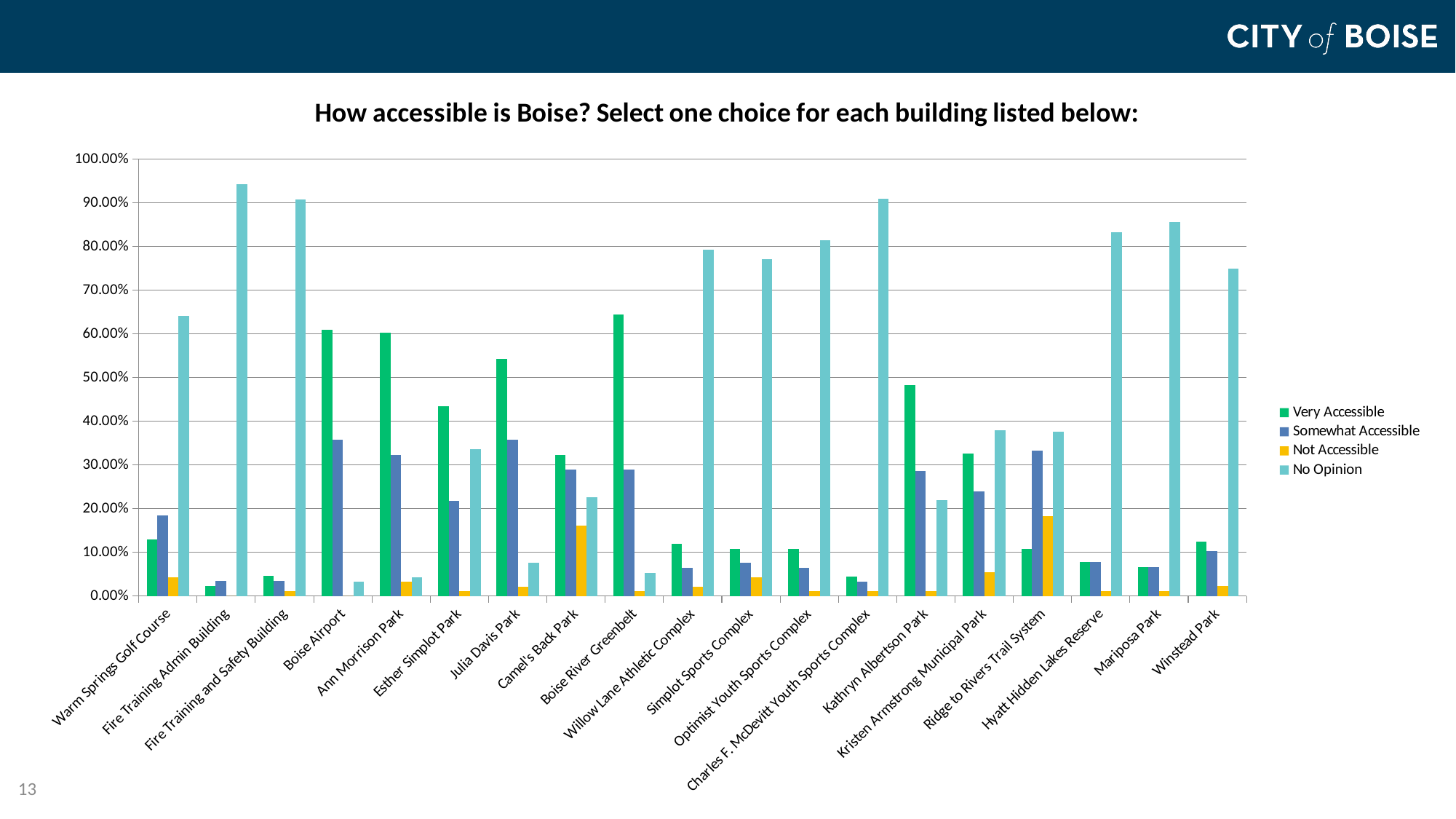
Which building has the lowest 'Very Accessible' value? Fire Training Admin Building What is the title of the chart? How accessible is Boise? Select one choice for each building listed below: Is the 'Very Accessible' value for Boise River Greenbelt greater or less than 60.00%? greater Which is larger: the 'Very Accessible' value for Julia Davis Park or for Esther Simplot Park? Julia Davis Park Which building has the highest 'Very Accessible' value? Boise River Greenbelt What kind of chart is shown on the slide? bar chart Is the 'Very Accessible' value for Kathryn Albertson Park greater or less than 50.00%? less How many buildings are listed along the x axis? 19 How many series does the legend list? 4 Is the 'No Opinion' value for Mariposa Park greater or less than 80.00%? greater